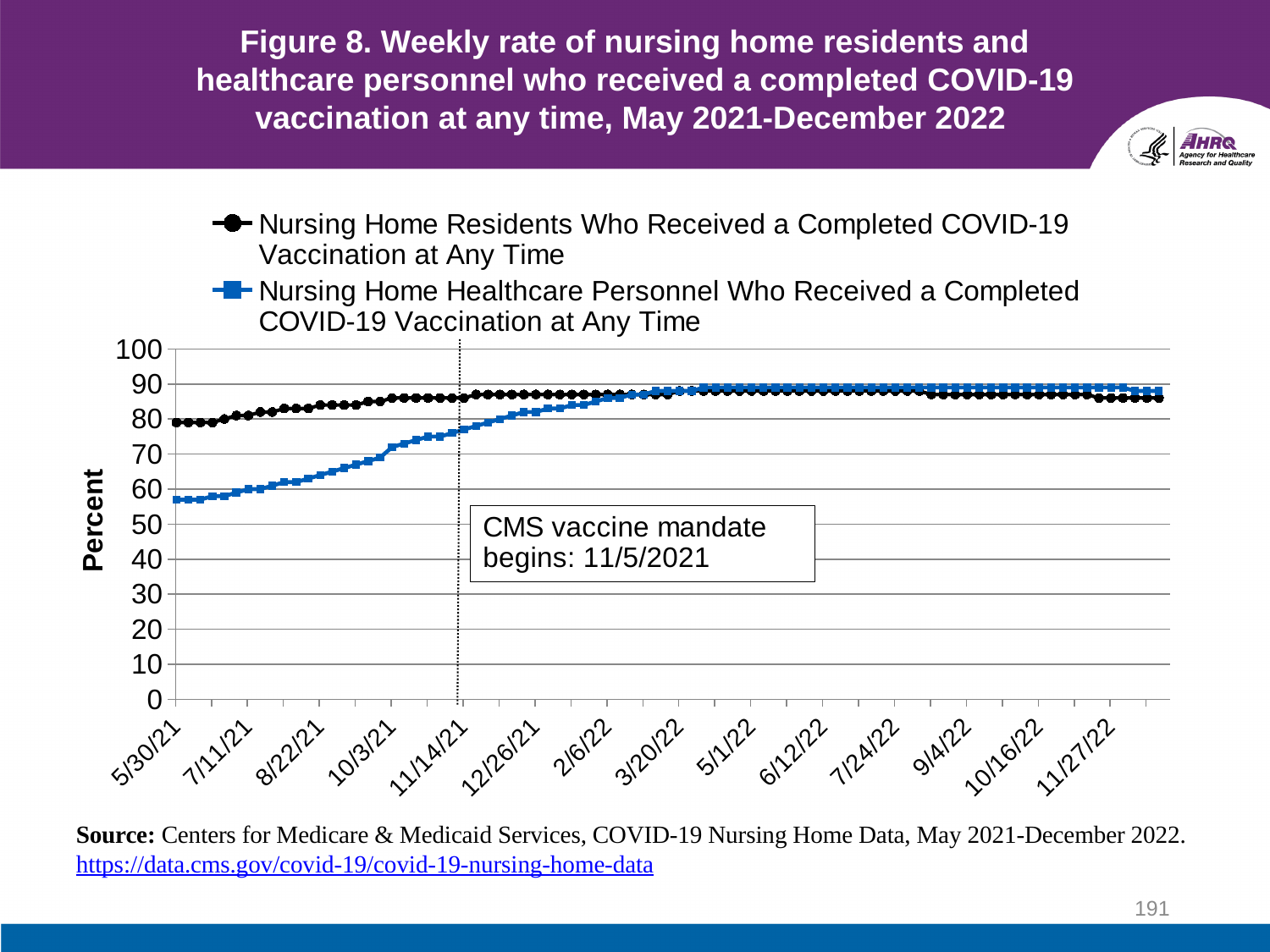
Is the value for Nursing Home Residents at 11/14/21 greater or less than 80? greater At 8/22/21, which series has the higher value: Nursing Home Residents or Nursing Home Healthcare Personnel? Nursing Home Residents How many series does the legend list? 2 At 5/30/21, which series has the higher value: Nursing Home Residents or Nursing Home Healthcare Personnel? Nursing Home Residents What is the label on the vertical axis? Percent What kind of chart is shown on the slide? Line chart Does the Nursing Home Healthcare Personnel series rise or fall from 5/30/21 to 3/20/22? Rise Is the value for Nursing Home Residents at 11/27/22 greater or less than 90? less Is the value for Nursing Home Healthcare Personnel at 5/30/21 greater or less than 50? greater According to the annotation on the chart, on what date does the CMS vaccine mandate begin? 11/5/2021